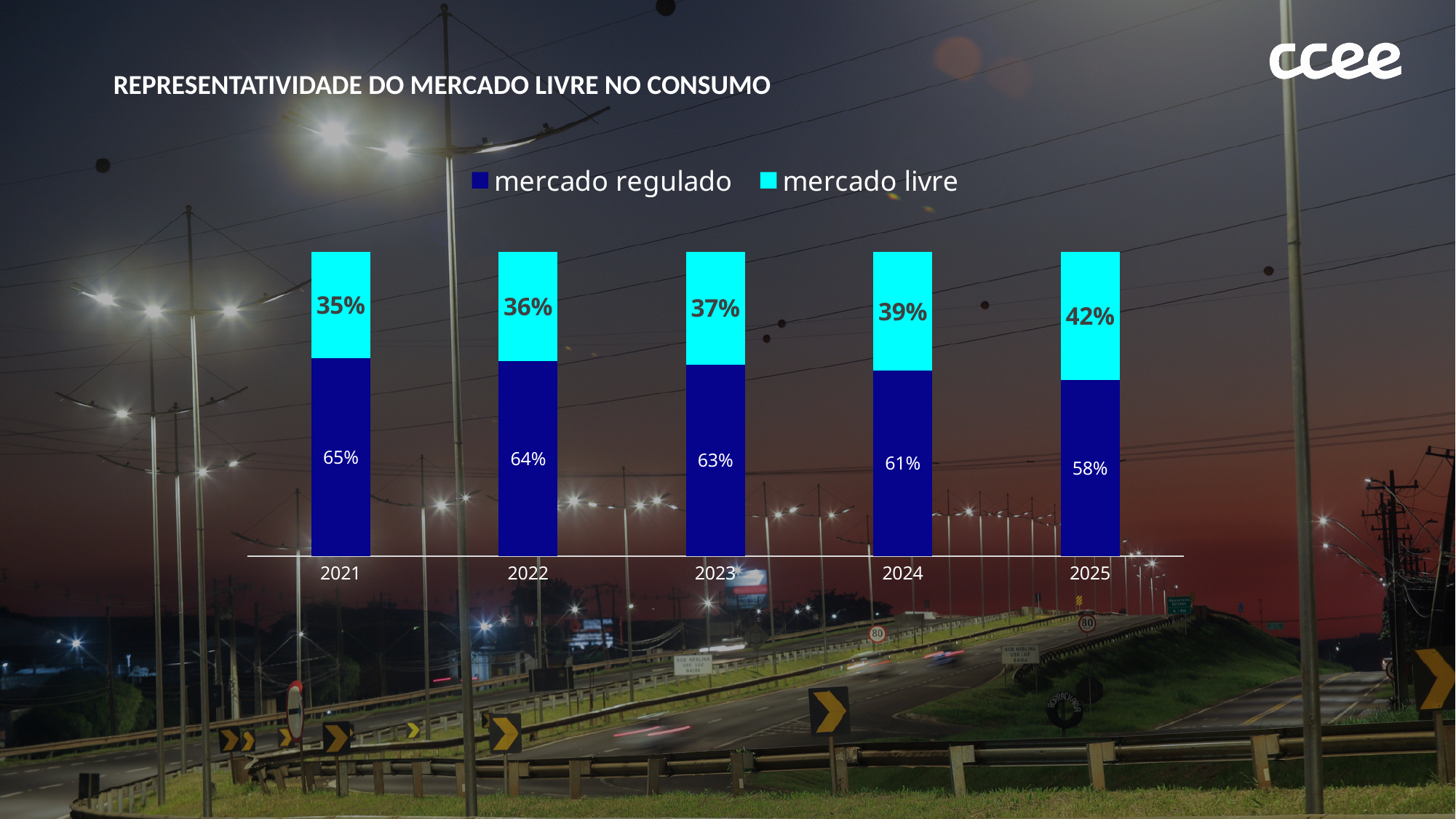
What kind of chart is shown on the slide? stacked bar chart What is the value for mercado livre in 2021? 35% In which year is the mercado livre share highest? 2025 Does the mercado livre share rise or fall from 2021 to 2025? rise How many years are shown on the x axis? 5 What is the value for mercado livre in 2024? 39% Which is larger in 2023: mercado regulado or mercado livre? mercado regulado What is the value for mercado regulado in 2025? 58% How many series does the legend list? 2 In which year is the mercado regulado share lowest? 2025 What is the total of the stacked bar for 2022? 100% What is the difference between the mercado livre values for 2025 and 2021? 7%